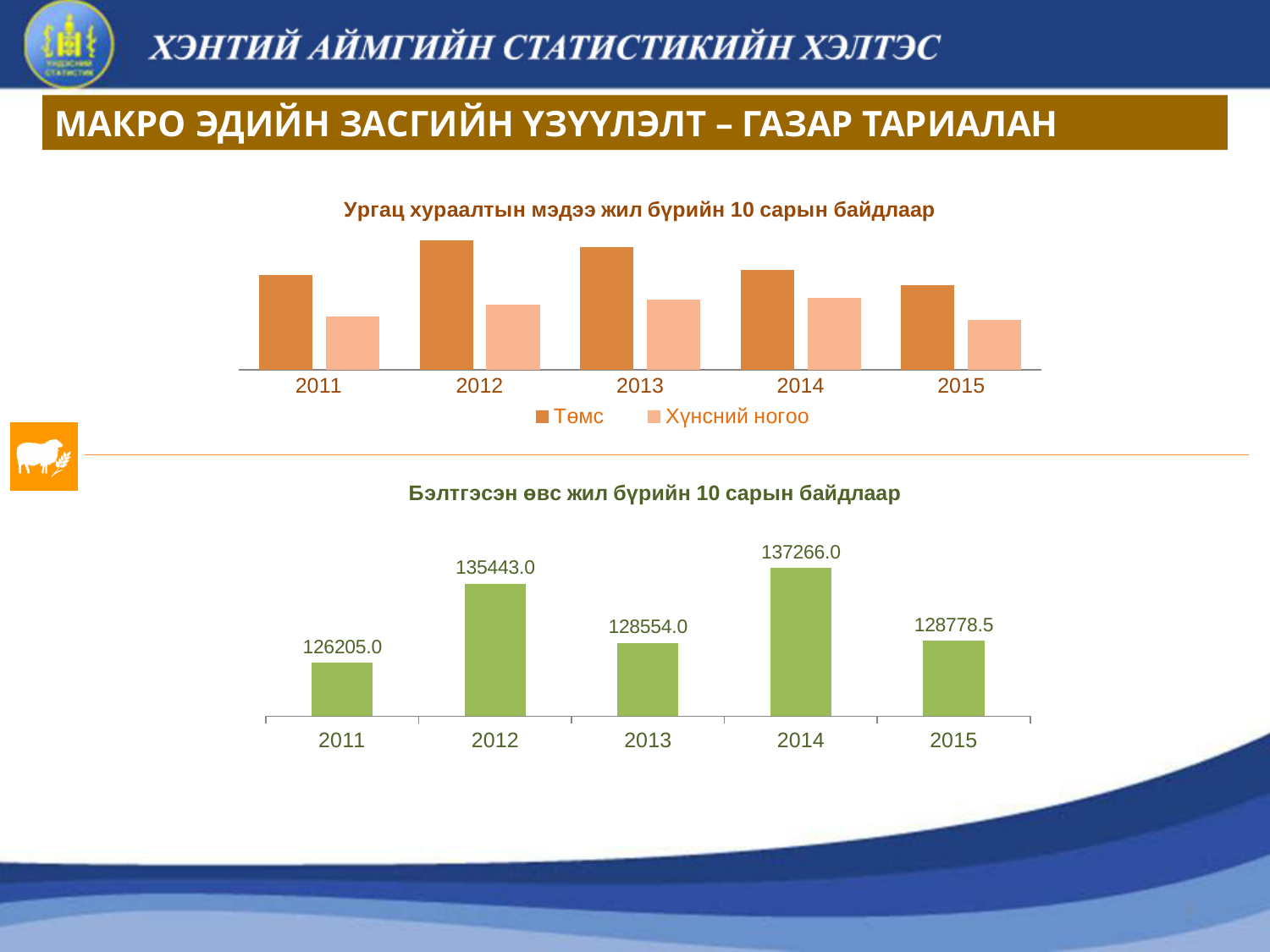
How many series does the legend of the top chart (Ургац хураалтын мэдээ жил бүрийн 10 сарын байдлаар) list? 2 What kind of chart is the top chart (Ургац хураалтын мэдээ жил бүрийн 10 сарын байдлаар)? Bar chart How many years are shown on the x axis of the bottom chart (Бэлтгэсэн өвс жил бүрийн 10 сарын байдлаар)? 5 In the bottom chart (Бэлтгэсэн өвс жил бүрийн 10 сарын байдлаар), what is the value for 2015? 128778.5 In the bottom chart (Бэлтгэсэн өвс жил бүрийн 10 сарын байдлаар), which year has the highest value? 2014 In the top chart (Ургац хураалтын мэдээ жил бүрийн 10 сарын байдлаар), which is larger in 2011, Төмс or Хүнсний ногоо? Төмс In the bottom chart (Бэлтгэсэн өвс жил бүрийн 10 сарын байдлаар), what is the value for 2014? 137266.0 In the bottom chart (Бэлтгэсэн өвс жил бүрийн 10 сарын байдлаар), what is the difference between the values for 2012 and 2013? 6889.0 In the bottom chart (Бэлтгэсэн өвс жил бүрийн 10 сарын байдлаар), which year has the lowest value? 2011 In the bottom chart (Бэлтгэсэн өвс жил бүрийн 10 сарын байдлаар), what is the value for 2011? 126205.0 In the bottom chart (Бэлтгэсэн өвс жил бүрийн 10 сарын байдлаар), what is the difference between the values for 2014 and 2011? 11061.0 In the bottom chart (Бэлтгэсэн өвс жил бүрийн 10 сарын байдлаар), which is larger, the value for 2012 or 2014? 2014